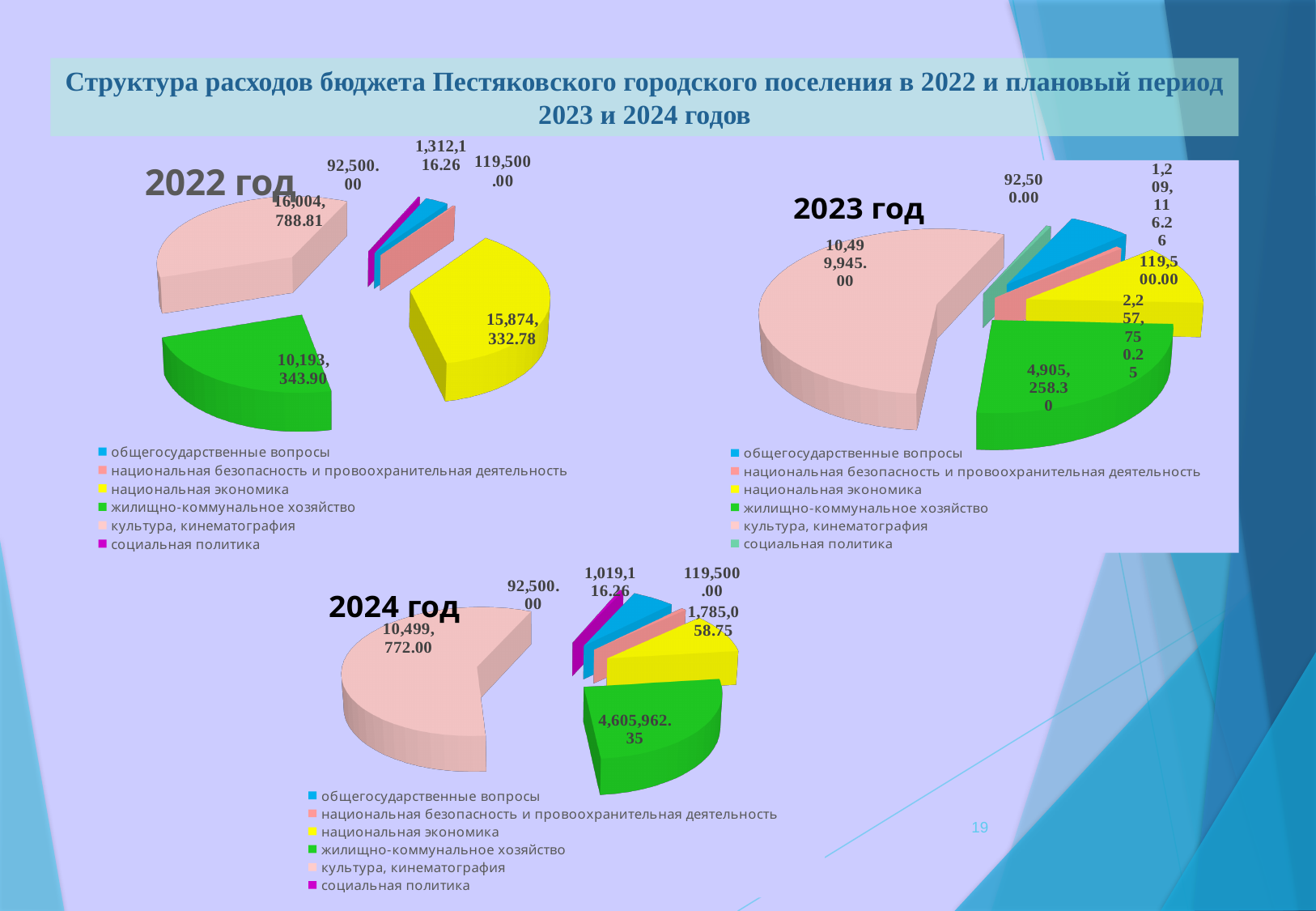
In the 2022 год chart, how many categories does the legend list? 6 In the 2024 год chart, which is larger: жилищно-коммунальное хозяйство or национальная экономика? жилищно-коммунальное хозяйство In the 2023 год chart, what is the value for культура, кинематография? 10,499,945.00 In the 2022 год chart, what is the value for национальная экономика? 15,874,332.78 In the 2024 год chart, what is the value for национальная экономика? 1,785,058.75 In the 2022 год chart, what is the value for жилищно-коммунальное хозяйство? 10,193,343.90 In the 2023 год chart, which category has the smallest value? социальная политика In the 2023 год chart, what is the value for общегосударственные вопросы? 1,209,116.26 What kind of charts are shown on the slide? Pie charts How many pie charts are on the slide? 3 In the 2024 год chart, which category has the largest value? культура, кинематография In the 2022 год chart, what is the difference between культура, кинематография and жилищно-коммунальное хозяйство? 5,811,444.91